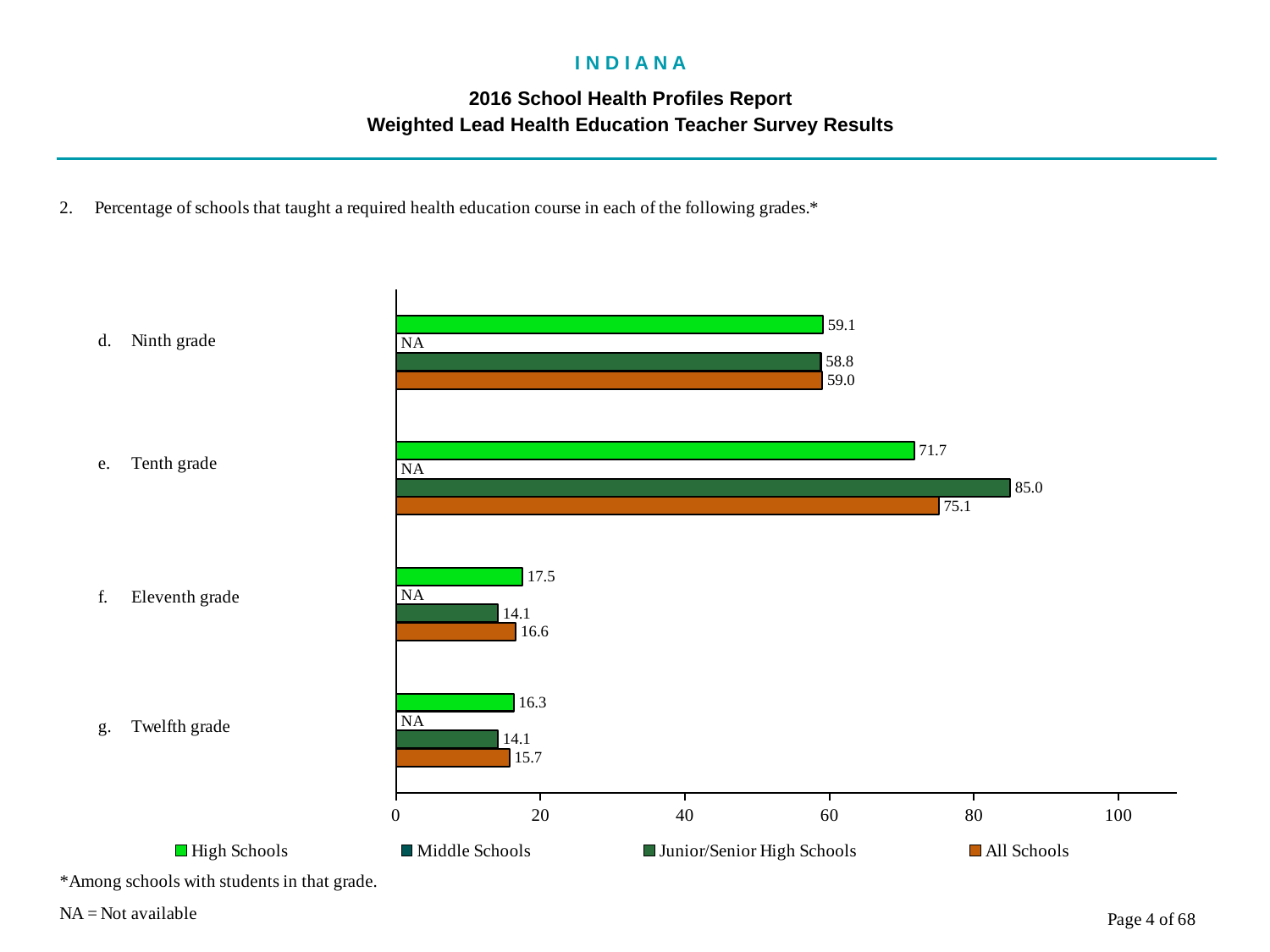
Which grade has the lowest value for High Schools? Twelfth grade Which is larger in Eleventh grade: the High Schools value or the All Schools value? High Schools Which grade has the highest value for Junior/Senior High Schools? Tenth grade What is the difference between the Junior/Senior High Schools value and the High Schools value in Tenth grade? 13.3 What is the value for High Schools in Tenth grade? 71.7 How many series does the legend list? 4 What is the value for All Schools in Twelfth grade? 15.7 Is the value for All Schools in Tenth grade greater or less than 60? greater What is the value for Junior/Senior High Schools in Ninth grade? 58.8 What kind of chart is shown on the slide? Bar chart What is the value for Middle Schools in Eleventh grade? NA How many grade categories are shown on the chart? 4